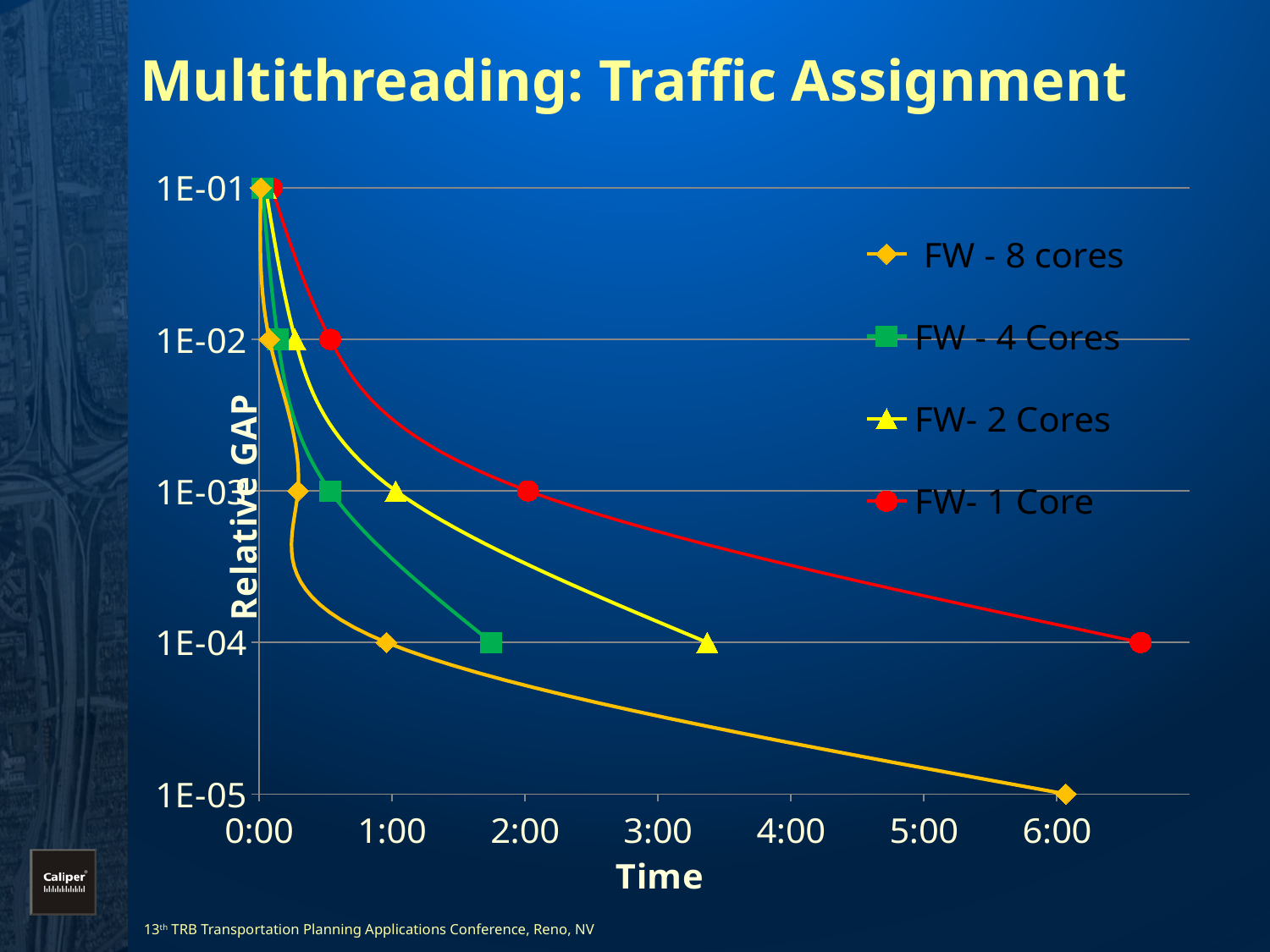
Does the relative GAP rise or fall as time increases? fall What is the title of the horizontal axis? Time What kind of chart is shown on the slide? line chart How many series does the legend list? 4 Is the time at which FW - 4 Cores reaches a relative GAP of 1E-04 greater or less than 2:00? less Is the time at which FW- 1 Core reaches a relative GAP of 1E-04 greater or less than 6:00? greater Which series takes the longest time to reach a relative GAP of 1E-04? FW- 1 Core What is the title of the vertical axis? Relative GAP What relative GAP value does the FW - 8 cores series reach at its final point? 1E-05 What relative GAP value does the FW- 1 Core series reach at its final point? 1E-04 Is the time at which FW- 2 Cores reaches a relative GAP of 1E-04 greater or less than 3:00? greater Which series reaches a relative GAP of 1E-04 sooner, FW - 8 cores or FW- 1 Core? FW - 8 cores